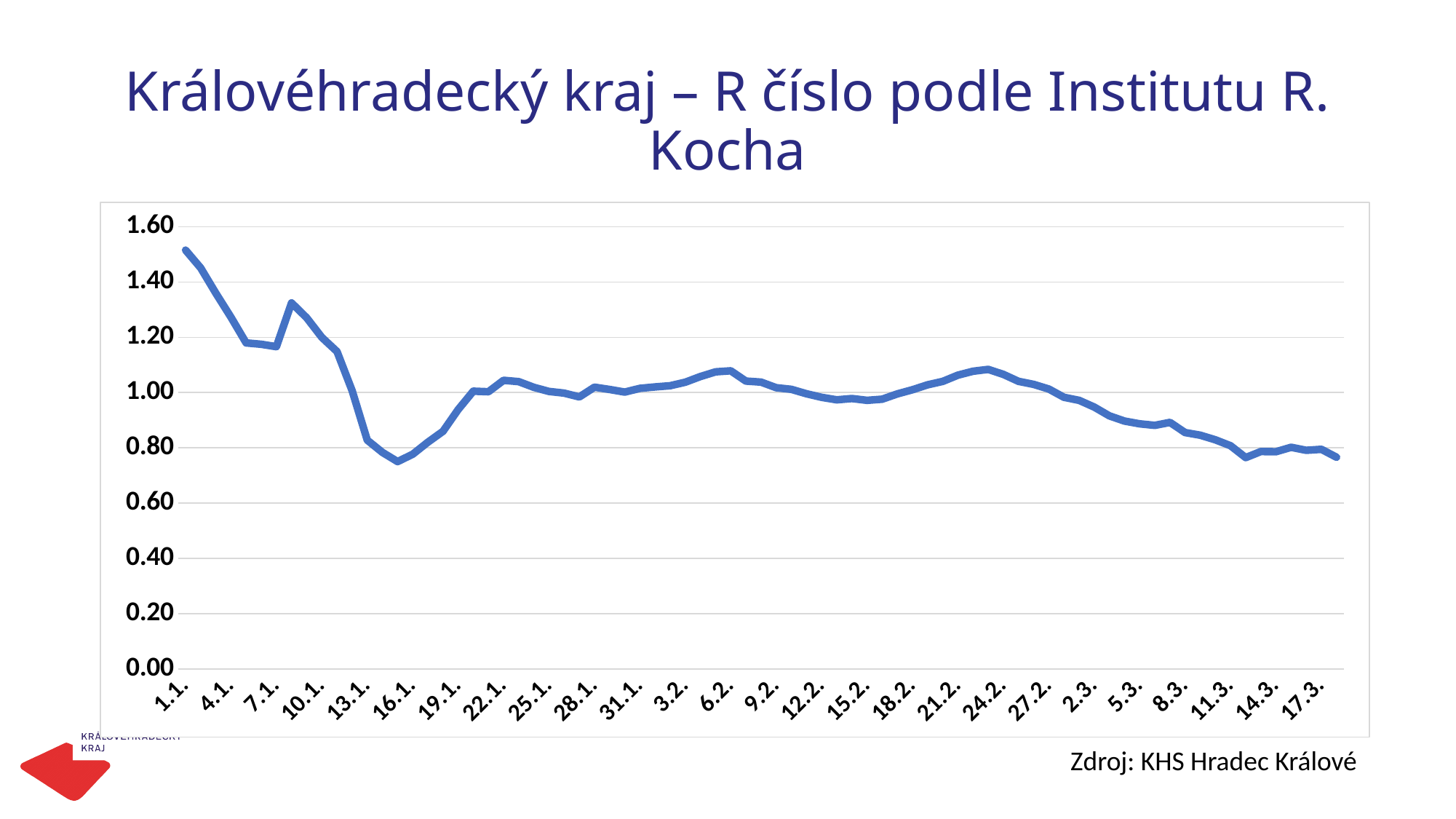
Which has the larger value, 1.1. or 17.3.? 1.1. Is the value for 1.1. greater or less than 1.40? greater Which has the larger value, 10.1. or 16.1.? 10.1. What is the title of the chart on the slide? Královéhradecký kraj – R číslo podle Institutu R. Kocha Is the value for 10.1. greater or less than 1.00? greater Is the value for 24.2. greater or less than 1.00? greater What source is cited below the chart? KHS Hradec Králové Which date on the x axis has the highest R value? 1.1. Overall, does the R value rise or fall from 1.1. to 17.3.? fall What kind of chart is shown on the slide? line chart